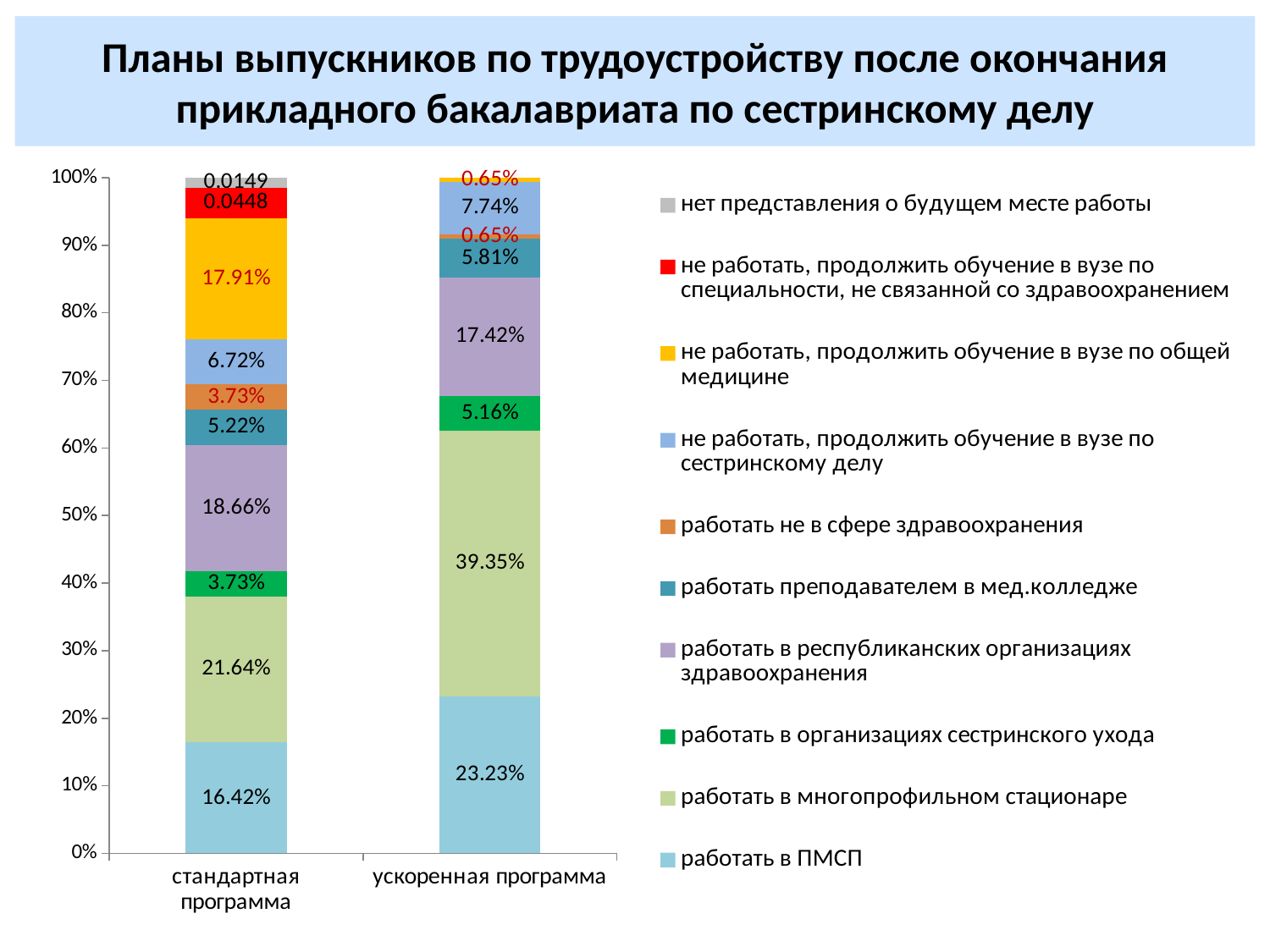
Which series has the largest segment in the 'стандартная программа' bar? работать в многопрофильном стационаре What is the difference between the 'работать в многопрофильном стационаре' values for 'ускоренная программа' and 'стандартная программа'? 17.71% Which programme has the larger value for 'работать в ПМСП'? ускоренная программа What is the value for 'не работать, продолжить обучение в вузе по сестринскому делу' in the 'ускоренная программа' bar? 7.74% What is the value for 'работать в ПМСП' in the 'стандартная программа' bar? 16.42% How many series does the legend list? 10 What kind of chart is shown on the slide? Stacked bar chart What is the value for 'не работать, продолжить обучение в вузе по общей медицине' in the 'стандартная программа' bar? 17.91% Which legend entry is shown in red? не работать, продолжить обучение в вузе по специальности, не связанной со здравоохранением How many categories (programmes) are shown on the x axis? 2 What is the value for 'работать в многопрофильном стационаре' in the 'ускоренная программа' bar? 39.35% What is the value for 'работать в республиканских организациях здравоохранения' in the 'ускоренная программа' bar? 17.42%